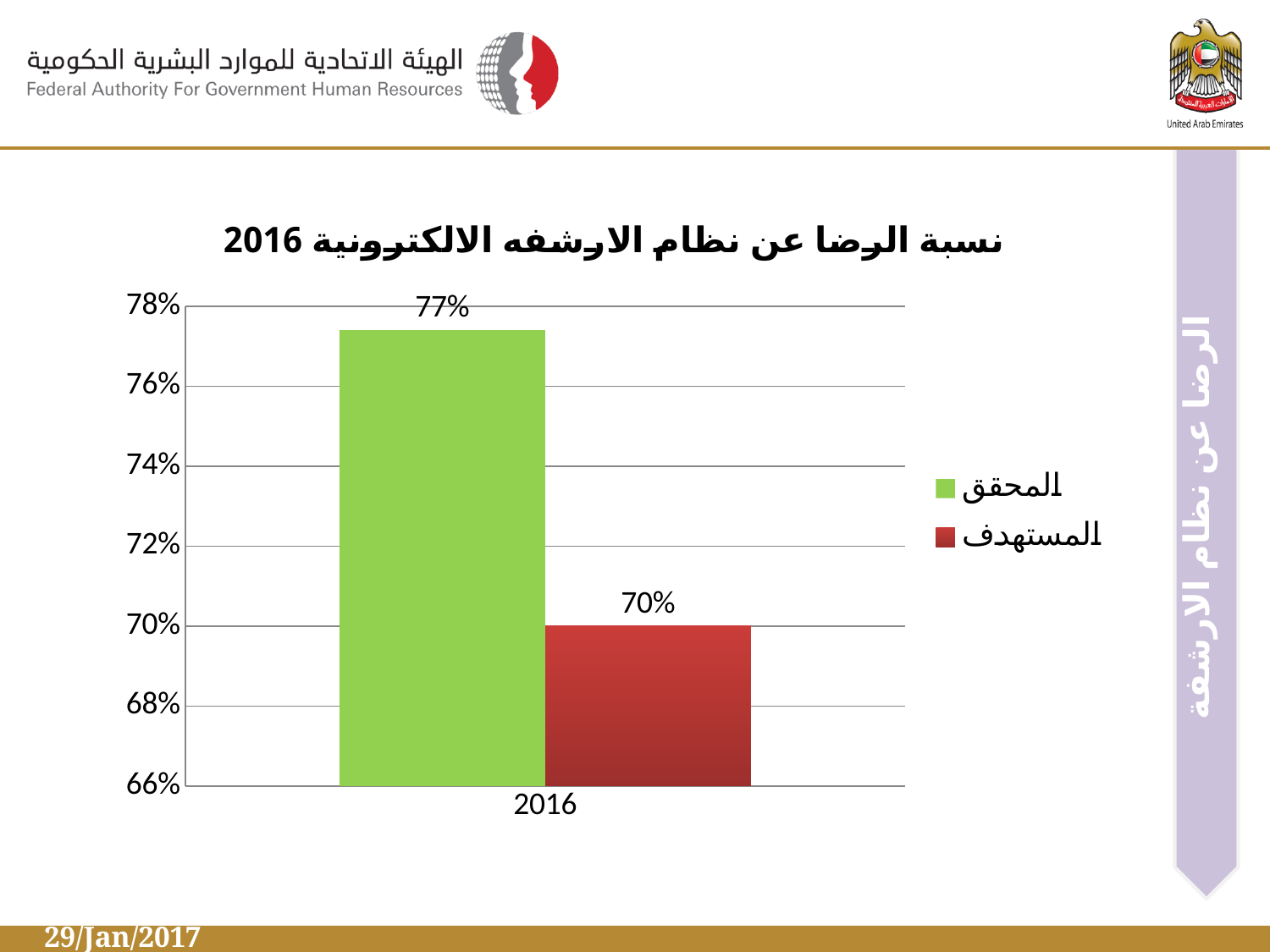
Which series has the higher value in 2016, المحقق or المستهدف? المحقق Which series has the lowest value in the chart? المستهدف What is the title of the chart? نسبة الرضا عن نظام الارشفه الالكترونية 2016 What is the value of المستهدف for 2016? 70% Is the value for المستهدف in 2016 greater or less than 72%? less How many categories are shown on the x axis? 1 Which colour represents المستهدف in the legend? Red How many series does the legend list? 2 What kind of chart is shown on the slide? Bar chart What is the difference between the المحقق value and the المستهدف value for 2016? 7% What is the value of المحقق for 2016? 77% Is the value for المحقق in 2016 greater or less than 76%? greater